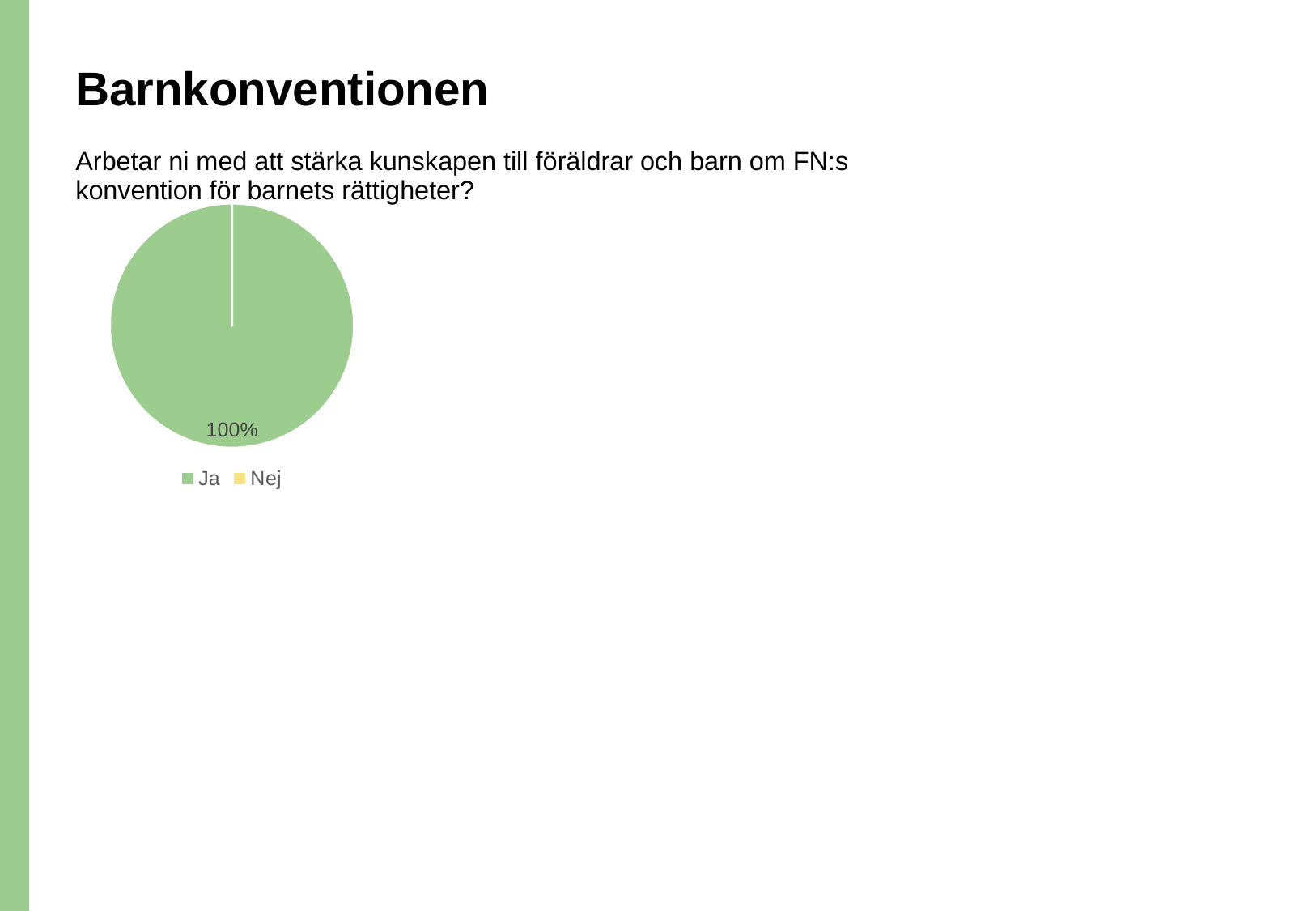
What share of the pie does "Ja" represent? 100% How many entries does the legend list? 2 What colour is used for "Nej" in the legend? yellow What colour is used for "Ja" in the chart? green Which category has the largest share of the pie? Ja Which is larger, the share for "Ja" or the share for "Nej"? Ja Which category has the smallest share of the pie? Nej What kind of chart is shown on the slide? pie chart What is the only data label printed on the pie chart? 100%